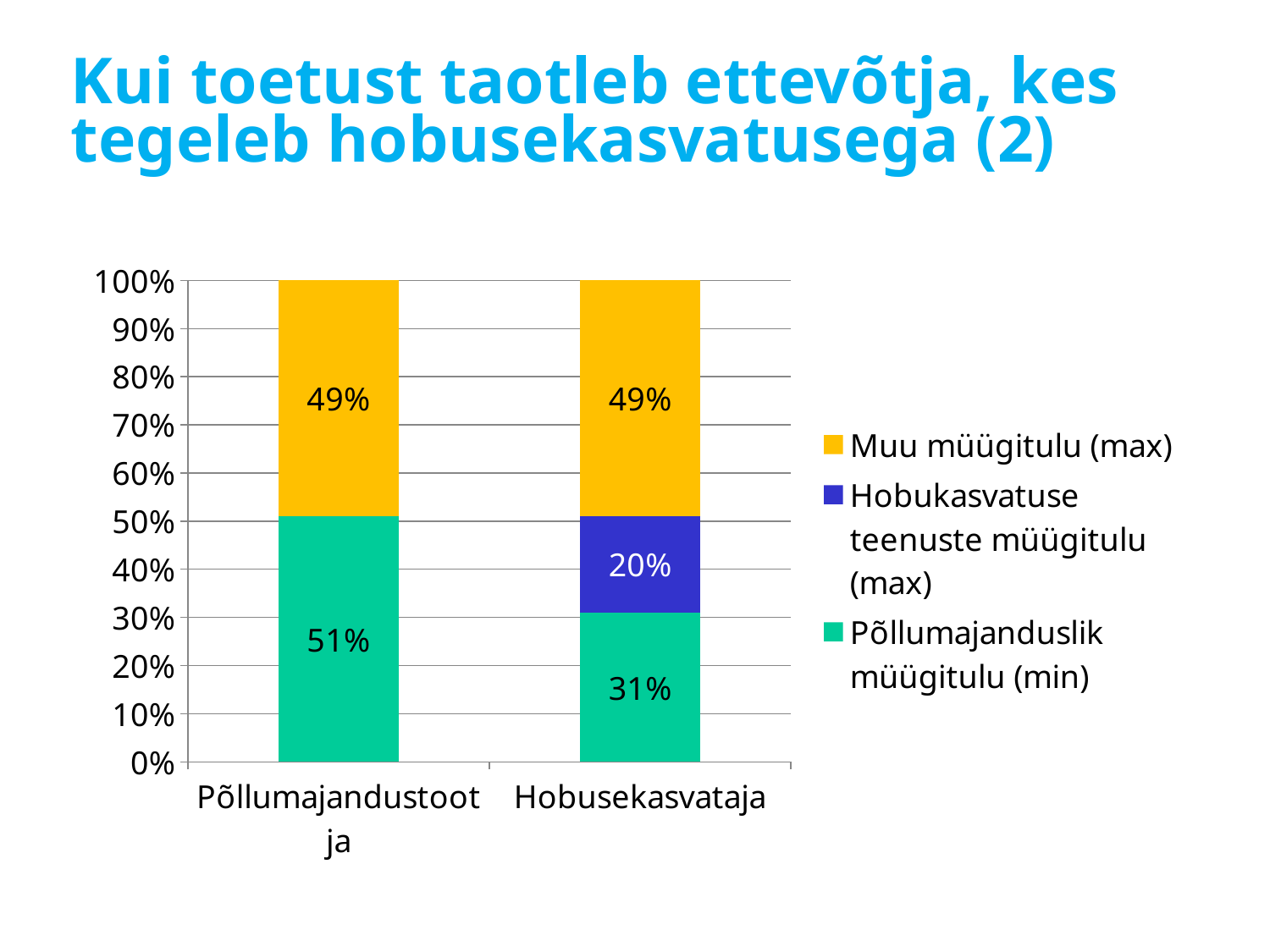
What is the value of Muu müügitulu (max) for Hobusekasvataja? 49% Which category has the larger Põllumajanduslik müügitulu (min) value, Põllumajandustootja or Hobusekasvataja? Põllumajandustootja What is the value of Põllumajanduslik müügitulu (min) for Hobusekasvataja? 31% What is the difference between the Põllumajanduslik müügitulu (min) values for Põllumajandustootja and Hobusekasvataja? 20% What is the value of Põllumajanduslik müügitulu (min) for Põllumajandustootja? 51% Which series has the largest value in the Hobusekasvataja bar? Muu müügitulu (max) How many series does the legend list? 3 What is the total of the stacked bar for Hobusekasvataja? 100% What kind of chart is shown on the slide? Stacked bar chart What is the value of Hobukasvatuse teenuste müügitulu (max) for Hobusekasvataja? 20% Which series has the smallest value in the Hobusekasvataja bar? Hobukasvatuse teenuste müügitulu (max) How many categories are shown on the x axis? 2